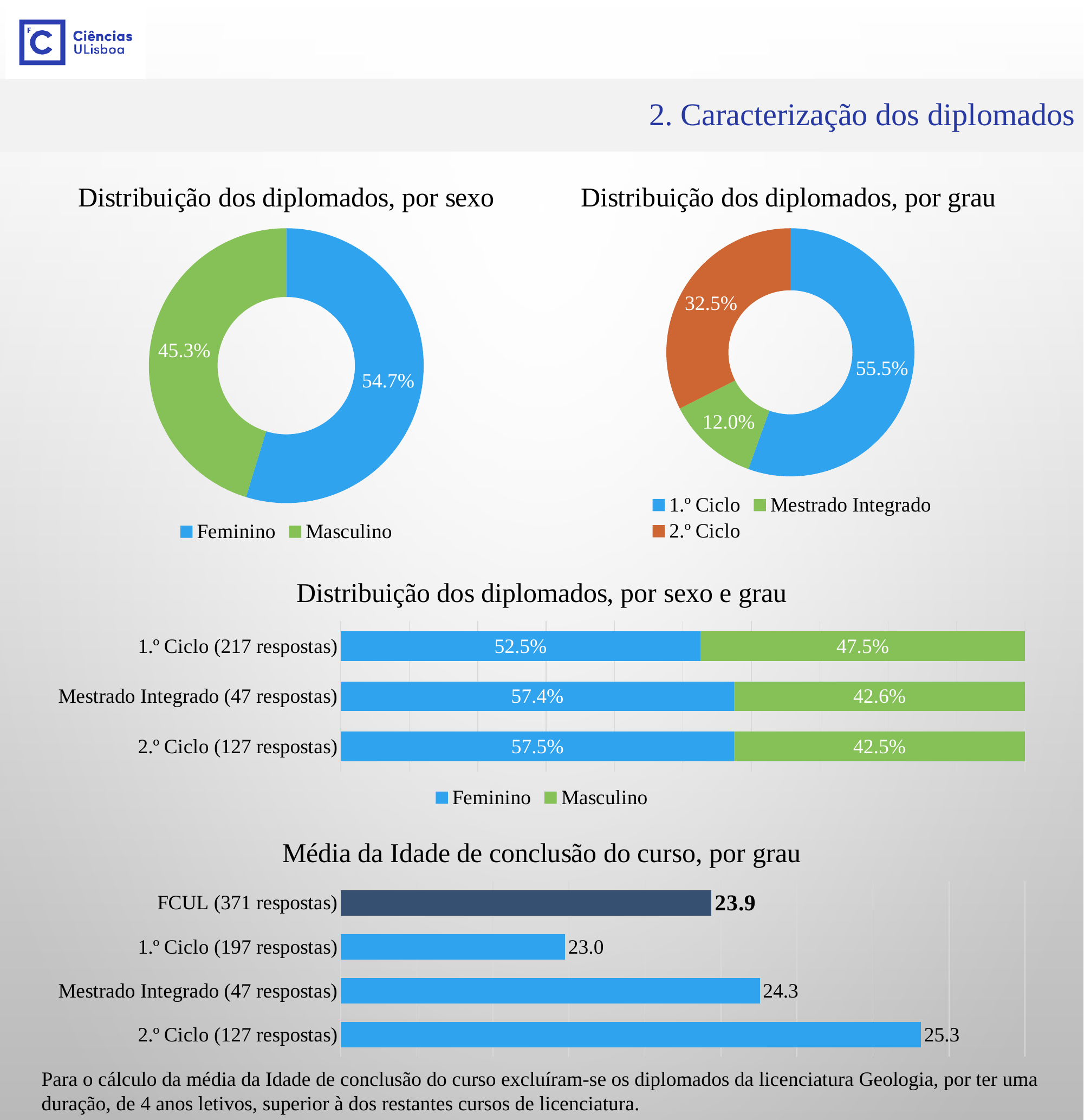
In the chart 'Distribuição dos diplomados, por grau', what share of graduates is 2.º Ciclo? 32.5% What kind of chart is 'Média da Idade de conclusão do curso, por grau'? Bar chart In the chart 'Distribuição dos diplomados, por sexo e grau', what is the Feminino value for 1.º Ciclo (217 respostas)? 52.5% In the chart 'Distribuição dos diplomados, por sexo e grau', what is the Masculino value for Mestrado Integrado (47 respostas)? 42.6% In the chart 'Distribuição dos diplomados, por grau', which degree has the smallest share? Mestrado Integrado In the chart 'Distribuição dos diplomados, por grau', how many categories does the legend list? 3 In the chart 'Média da Idade de conclusão do curso, por grau', which category has the highest average age? 2.º Ciclo (127 respostas) In the chart 'Distribuição dos diplomados, por sexo', what share of graduates is Masculino? 45.3% In the chart 'Média da Idade de conclusão do curso, por grau', what is the value for FCUL (371 respostas)? 23.9 In the chart 'Média da Idade de conclusão do curso, por grau', what is the difference between 2.º Ciclo (127 respostas) and 1.º Ciclo (197 respostas)? 2.3 In the chart 'Distribuição dos diplomados, por sexo e grau', which degree has the highest Feminino share? 2.º Ciclo (127 respostas) In the chart 'Distribuição dos diplomados, por sexo', what share of graduates is Feminino? 54.7%